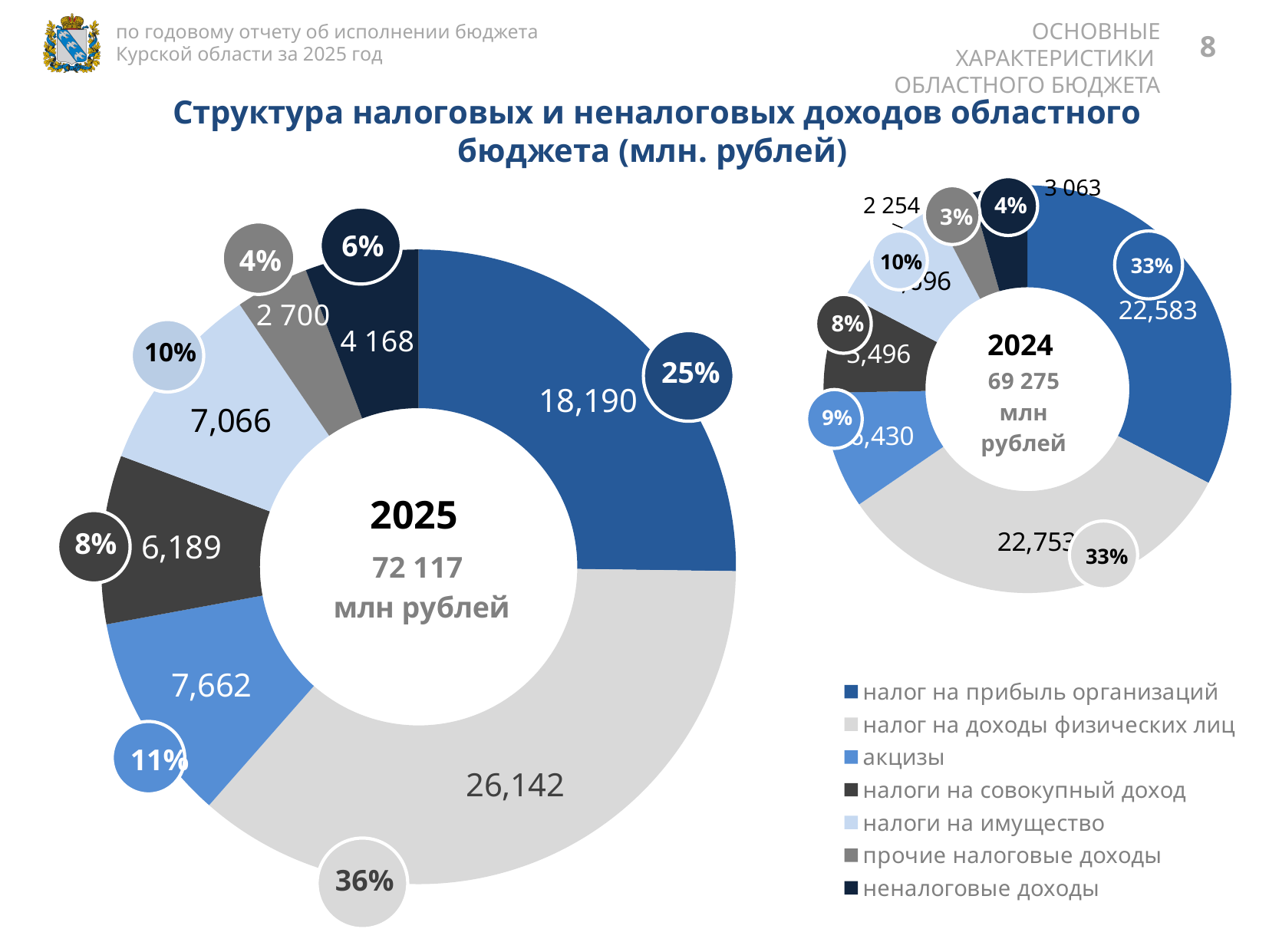
In the 2024 donut chart, what is the value for налог на прибыль организаций? 22,583 What type of chart is used on this slide? Donut (pie) chart In the 2025 donut chart, what is the value for акцизы? 7,662 In the 2025 donut chart, which is larger: акцизы or налоги на совокупный доход? акцизы In the 2025 donut chart, what is the value for налог на прибыль организаций? 18,190 In the 2025 donut chart, which category has the largest share? налог на доходы физических лиц In the 2025 donut chart, what is the difference between налог на доходы физических лиц and налог на прибыль организаций? 7,952 How many categories does the legend list? 7 In the 2025 donut chart, what share does налоги на имущество have? 10% In the 2025 donut chart, which category has the smallest share? прочие налоговые доходы What total is shown in the centre of the 2024 donut chart? 69 275 млн рублей In the 2025 donut chart, what is the value for налог на доходы физических лиц? 26,142